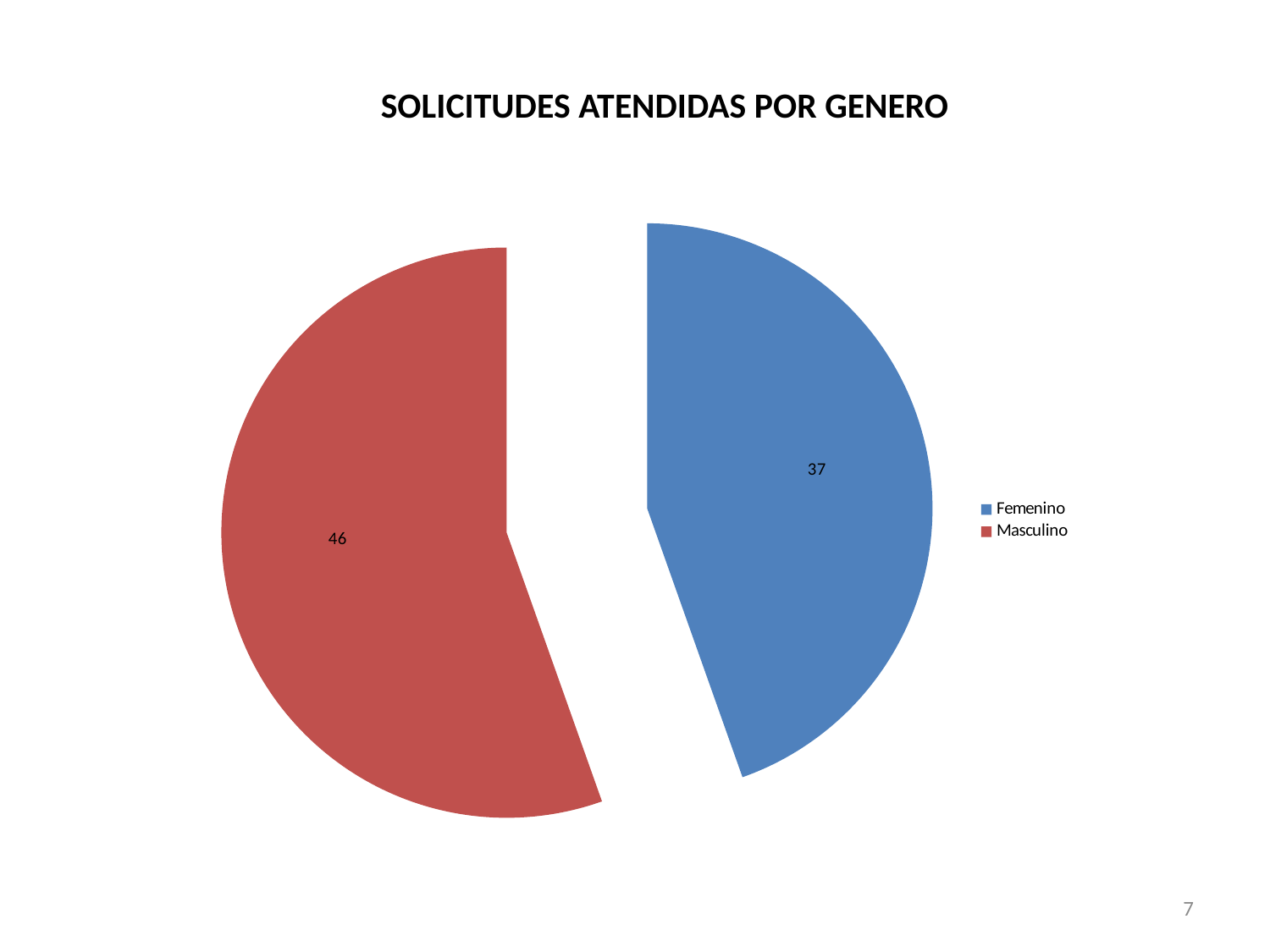
Which is larger, Femenino or Masculino? Masculino What is the title of the chart? SOLICITUDES ATENDIDAS POR GENERO What is the value for Femenino? 37 How many entries does the legend list? 2 How many slices does the pie chart have? 2 Which category has the largest slice? Masculino What kind of chart is shown on the slide? Pie chart Which category has the smallest slice? Femenino What colour is the Femenino slice? Blue What is the total of the two slices? 83 What is the value for Masculino? 46 What is the difference between the Masculino and Femenino values? 9